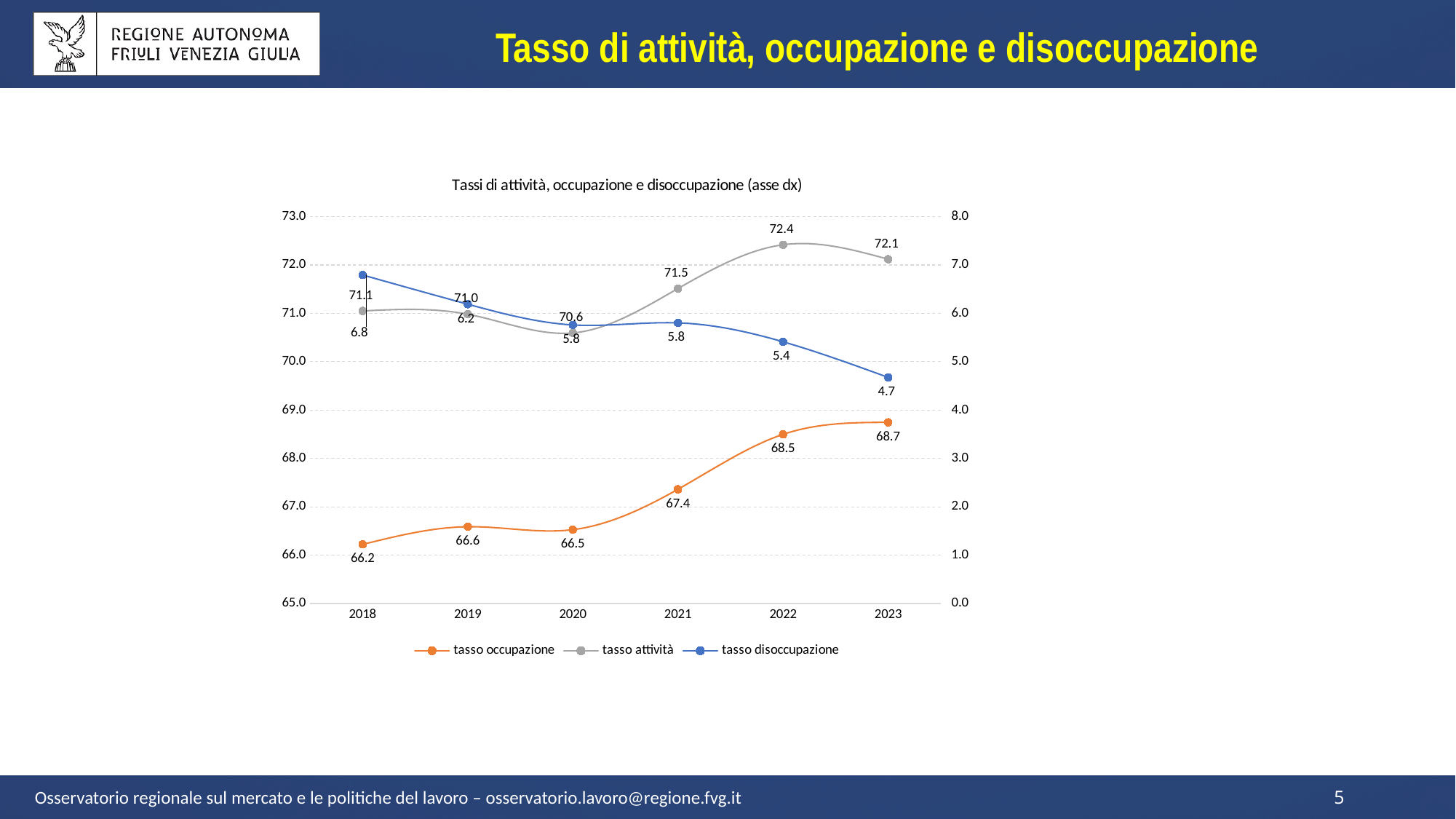
Does tasso disoccupazione generally rise or fall from 2018 to 2023? fall In which year is tasso attività highest? 2022 What kind of chart is shown on the slide? line chart What is the value of tasso disoccupazione in 2023? 4.7 How many series does the legend list? 3 What is the value of tasso attività in 2022? 72.4 What is the difference between tasso occupazione in 2023 and in 2018? 2.5 How many years are shown on the x axis? 6 What is the value of tasso occupazione in 2021? 67.4 Which is larger: tasso disoccupazione in 2018 or in 2022? 2018 In which year is tasso occupazione lowest? 2018 What is the title of the chart? Tassi di attività, occupazione e disoccupazione (asse dx)